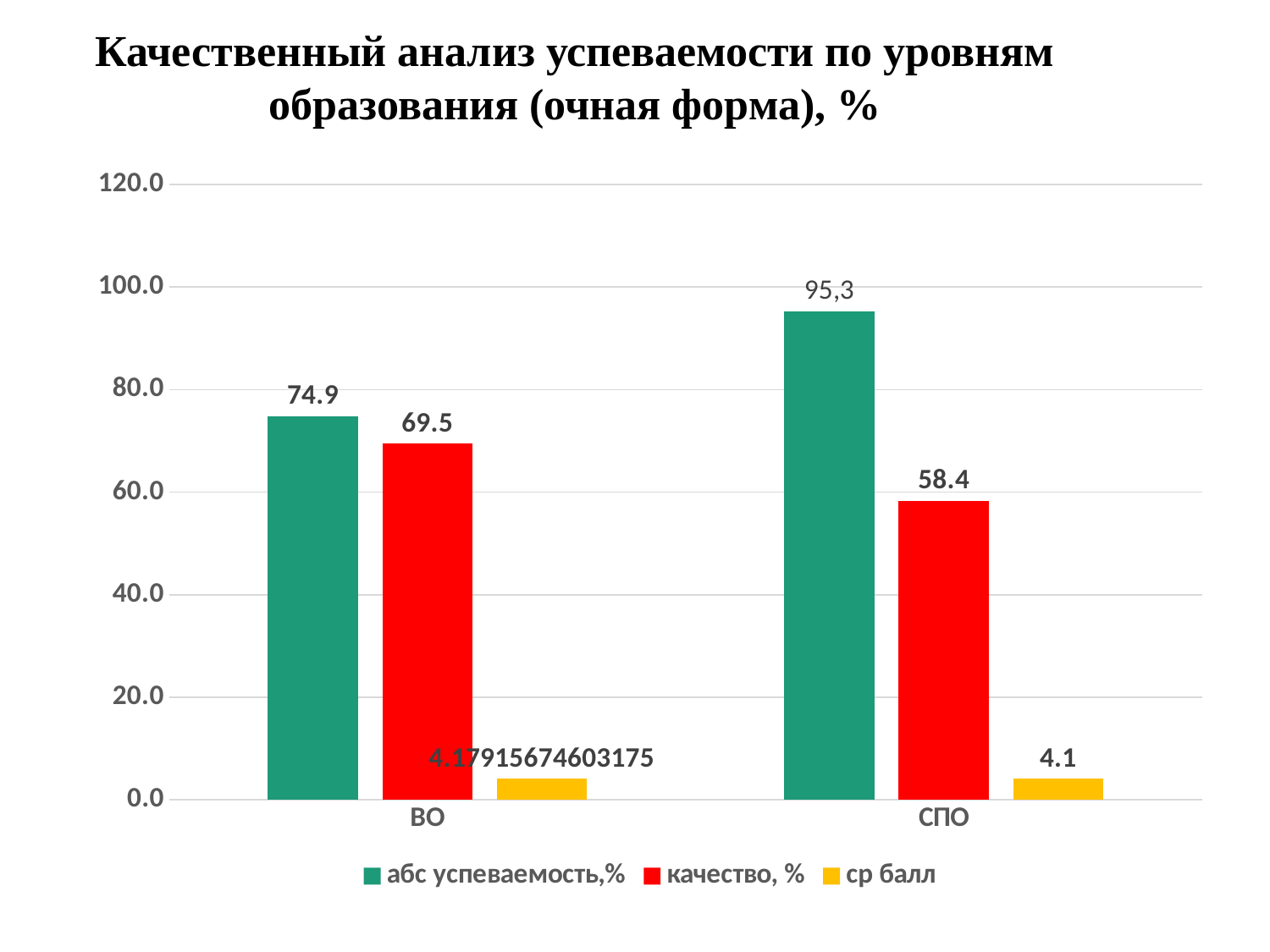
What is the value of качество, % for ВО? 69.5 What kind of chart is shown on the slide? bar chart What is the value of ср балл for СПО? 4.1 What is the difference between качество, % for ВО and for СПО? 11.1 Is the value of абс успеваемость,% for СПО greater or less than 80.0? greater How many series does the legend list? 3 Which category has the higher value for абс успеваемость,%? СПО Which category has the lower value for качество, %? СПО What is the value of абс успеваемость,% for ВО? 74.9 What is the value of абс успеваемость,% for СПО? 95,3 How many categories are shown on the x axis? 2 What is the value of качество, % for СПО? 58.4